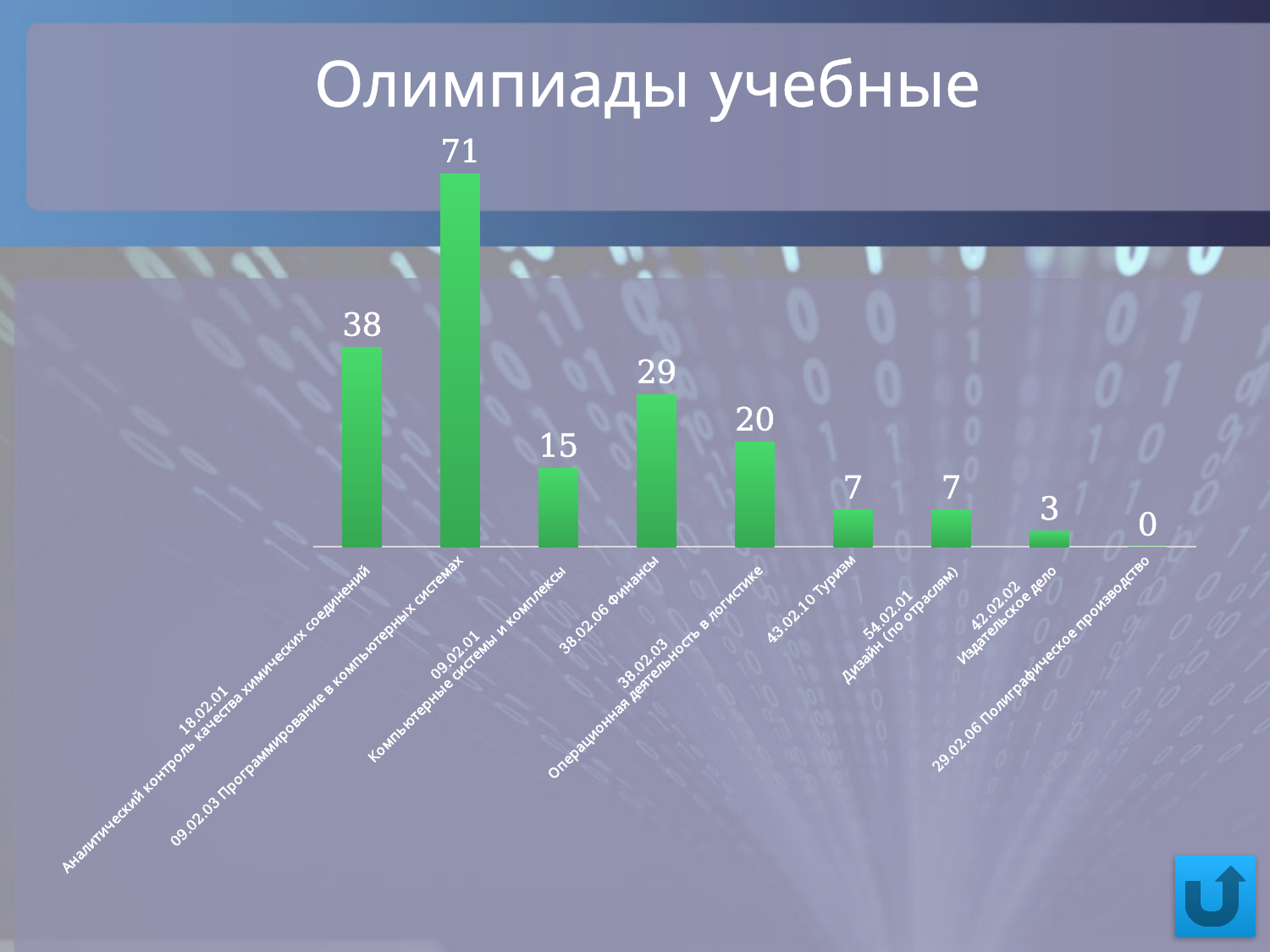
Which is larger, the value for 09.02.01 Компьютерные системы и комплексы or the value for 38.02.03 Операционная деятельность в логистике? 38.02.03 Операционная деятельность в логистике What kind of chart is shown on the slide? bar chart What is the value for 09.02.03 Программирование в компьютерных системах? 71 What is the title of the slide? Олимпиады учебные What is the difference between the values for 38.02.06 Финансы and 38.02.03 Операционная деятельность в логистике? 9 How many categories are shown in the chart? 9 What is the value for 38.02.06 Финансы? 29 What is the value for 43.02.10 Туризм? 7 What is the value for 29.02.06 Полиграфическое производство? 0 What is the difference between the values for 09.02.03 Программирование в компьютерных системах and 18.02.01 Аналитический контроль качества химических соединений? 33 Which category has the lowest value? 29.02.06 Полиграфическое производство Which category has the highest value? 09.02.03 Программирование в компьютерных системах